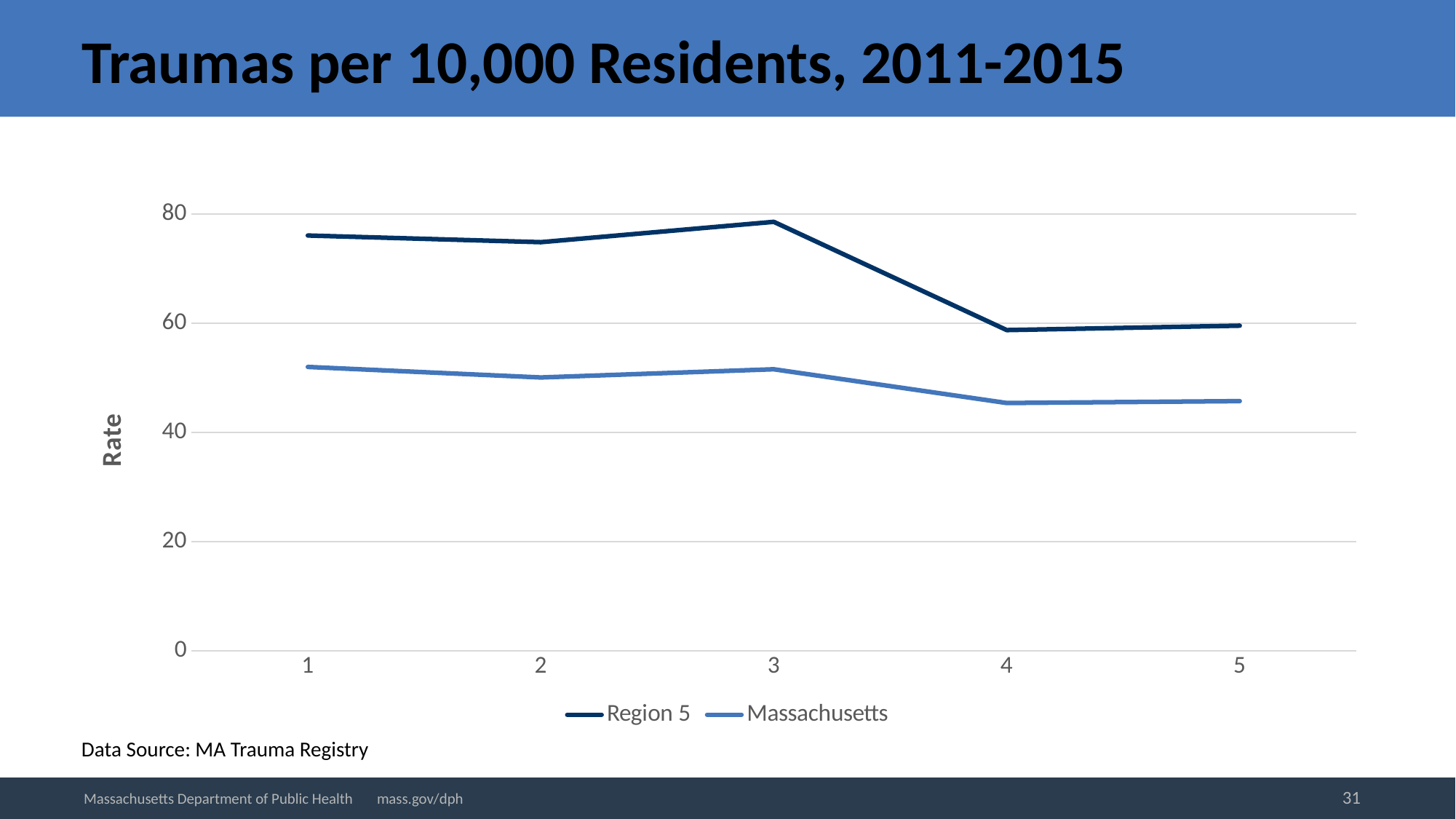
How many series does the legend list? 2 Is the value for Region 5 at point 1 greater or less than 80? less Which series has the higher value at point 3, Region 5 or Massachusetts? Region 5 What kind of chart is shown on the slide? Line chart How many points are plotted along the x axis for each series? 5 Which series has the lower value at point 1, Region 5 or Massachusetts? Massachusetts What is the label on the y axis of the chart? Rate At which x-axis point does the Region 5 line reach its highest value? 3 Is the value for Region 5 at point 3 greater or less than 60? greater Is the value for Massachusetts at point 1 greater or less than 40? greater Do the Region 5 values overall rise or fall from point 1 to point 5? fall